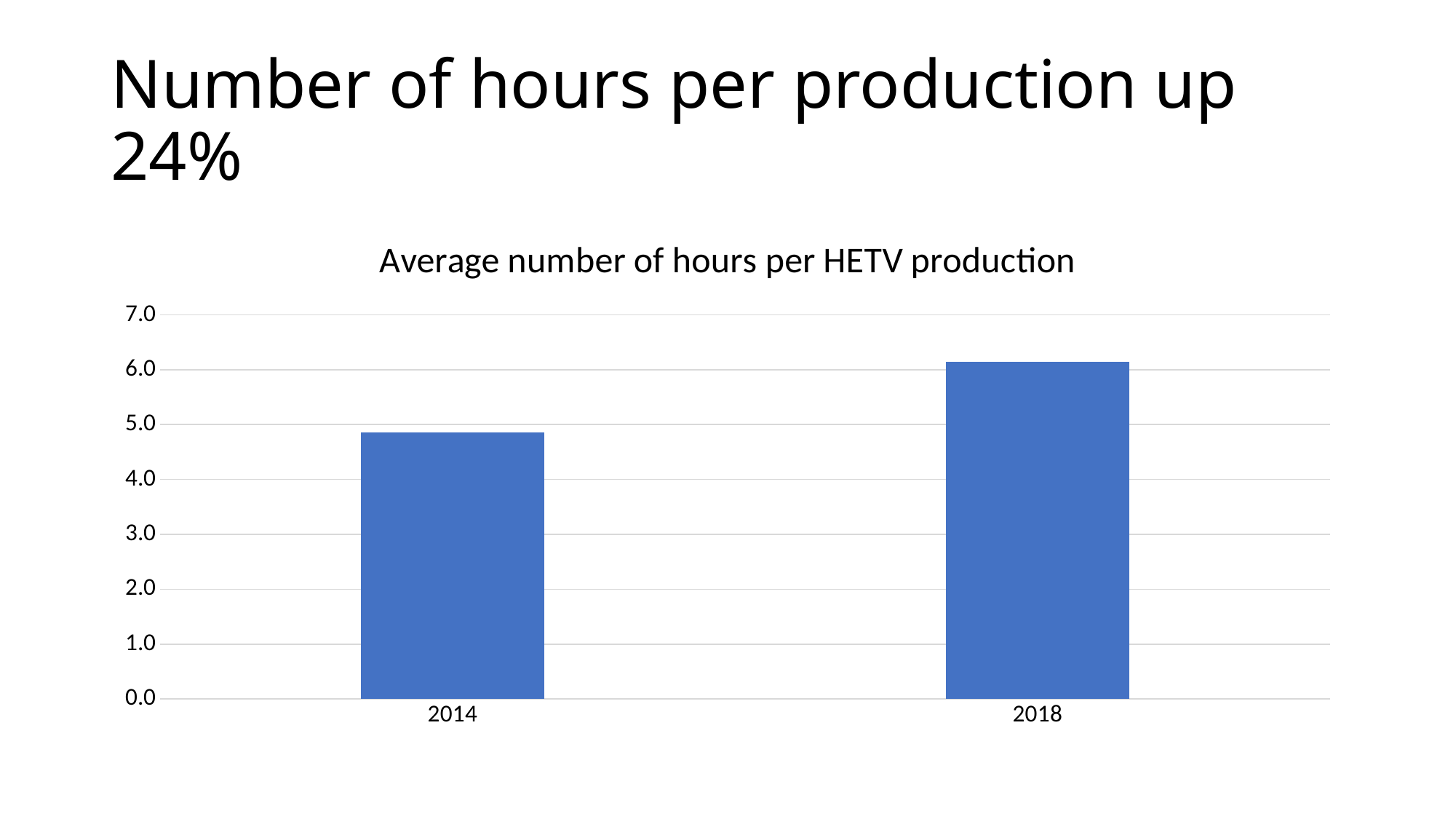
What is the highest value shown on the y axis of the chart? 7.0 Do the values rise or fall from 2014 to 2018? rise How many categories are shown on the x axis of the chart? 2 Is the bar for 2018 larger or smaller than the bar for 2014? larger Which year has the lower average number of hours per HETV production? 2014 Is the value for 2018 greater or less than 6.0? greater Is the value for 2014 greater or less than 4.0? greater What is the title of the chart? Average number of hours per HETV production Which year has the higher average number of hours per HETV production? 2018 What type of chart is shown on the slide? bar chart Is the value for 2014 greater or less than 5.0? less